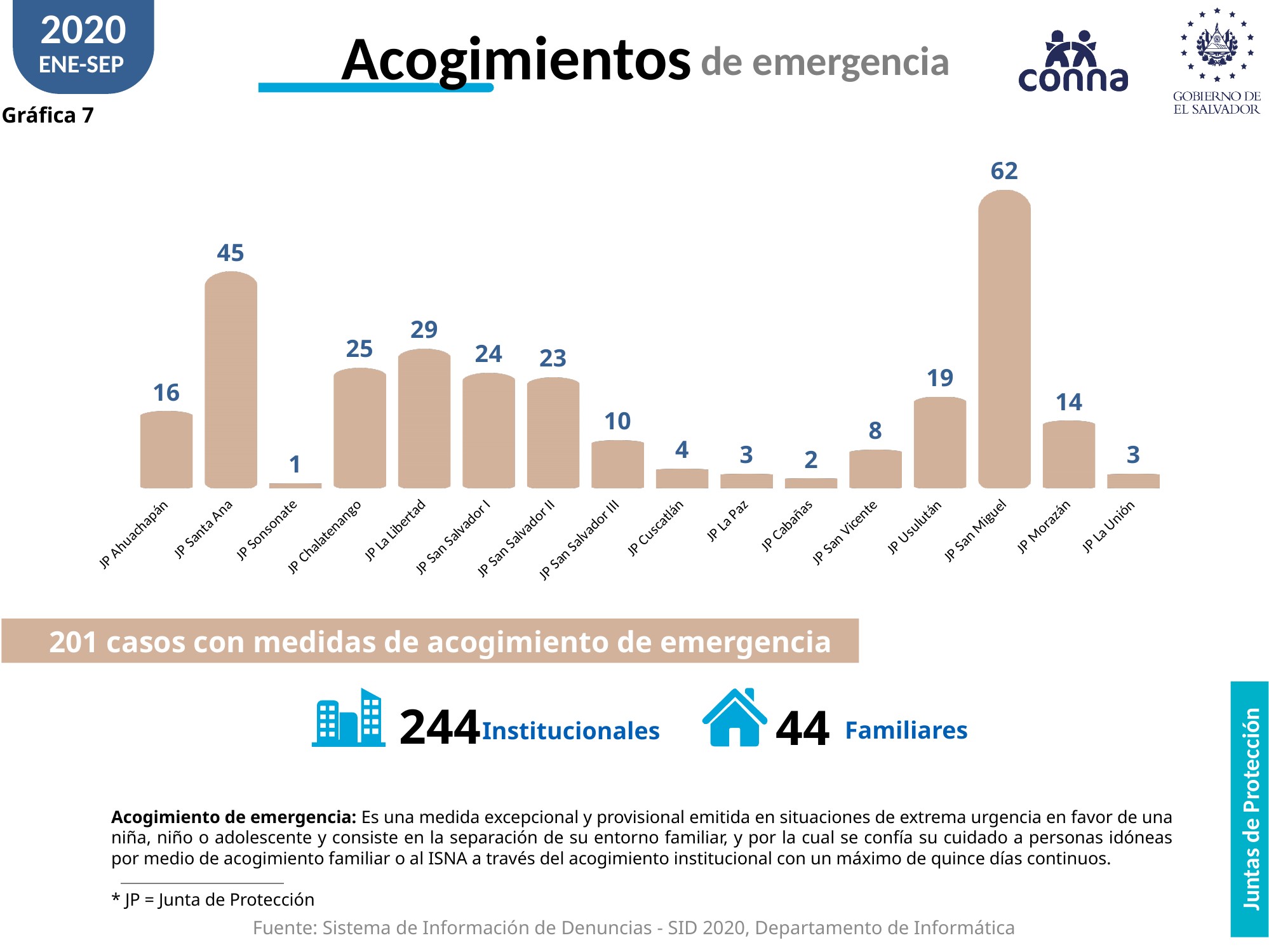
How many categories are shown in the chart? 16 Which category has the highest value? JP San Miguel Which category has the lowest value? JP Sonsonate What is the value for JP San Salvador III? 10 Which is larger, the value for JP La Libertad or the value for JP San Salvador I? JP La Libertad Which is larger, the value for JP Ahuachapán or the value for JP San Vicente? JP Ahuachapán What kind of chart is shown on the slide? Bar chart What is the difference between the values for JP Chalatenango and JP Usulután? 6 What is the value for JP Santa Ana? 45 What is the title of the chart? Acogimientos de emergencia What is the value for JP Morazán? 14 What is the difference between the values for JP San Miguel and JP Santa Ana? 17